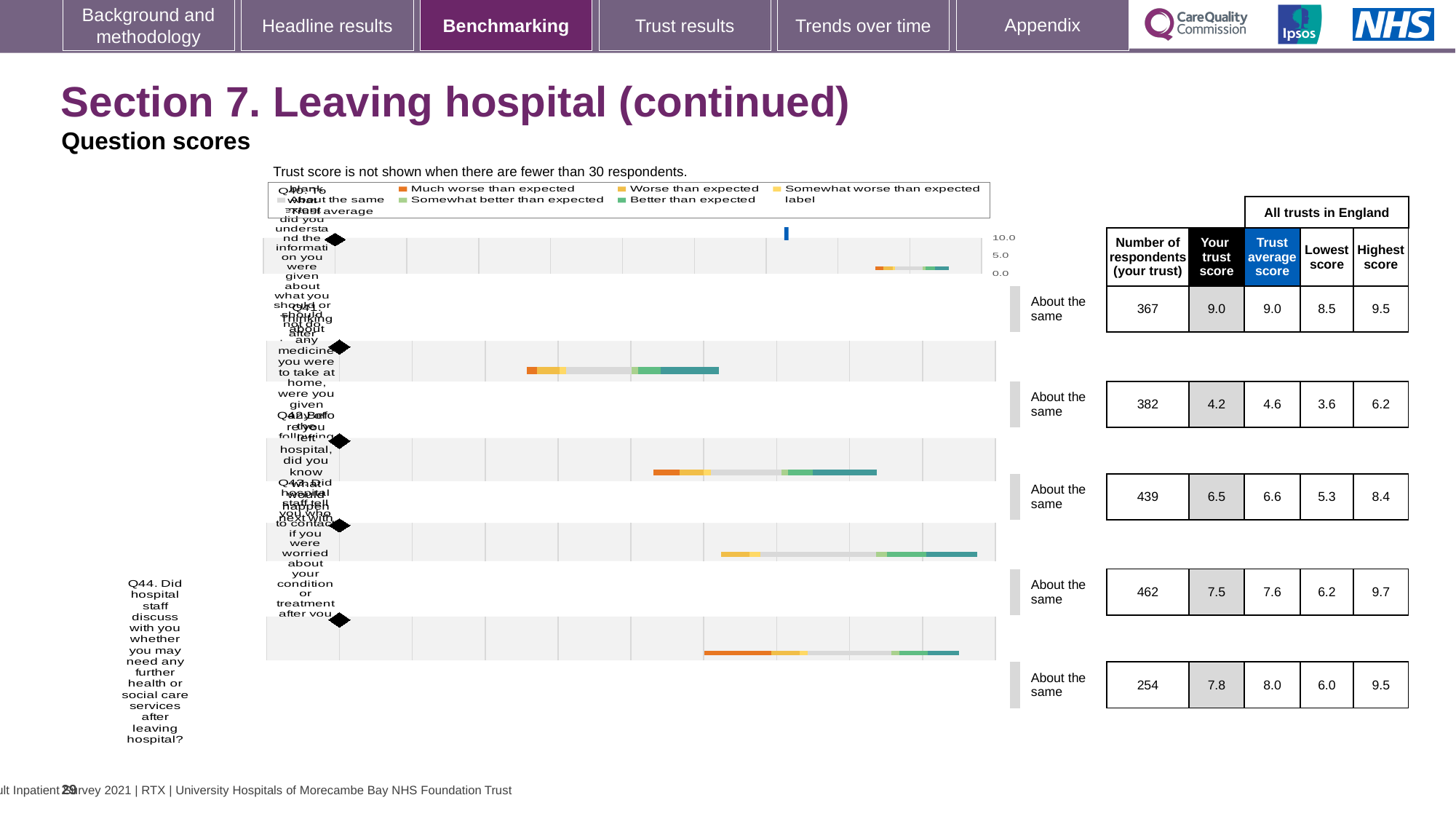
How many question rows are shown in the table? 5 What benchmark category is shown next to the Q44 row? About the same What is the 'Your trust score' value for Q44? 7.8 For Q44, what is the difference between the trust average score and your trust score? 0.2 What is the trust average score for Q44? 8.0 What is the smallest number of respondents listed in the table? 254 For Q44, which is larger: your trust score or the trust average score? Trust average score What is the lowest score across all trusts in England for Q44? 6.0 What is the largest number of respondents listed in the table? 462 How many respondents are shown for Q44 in the table? 254 What kind of chart is used to show the question scores? Bar chart What is the highest score across all trusts in England for Q44? 9.5